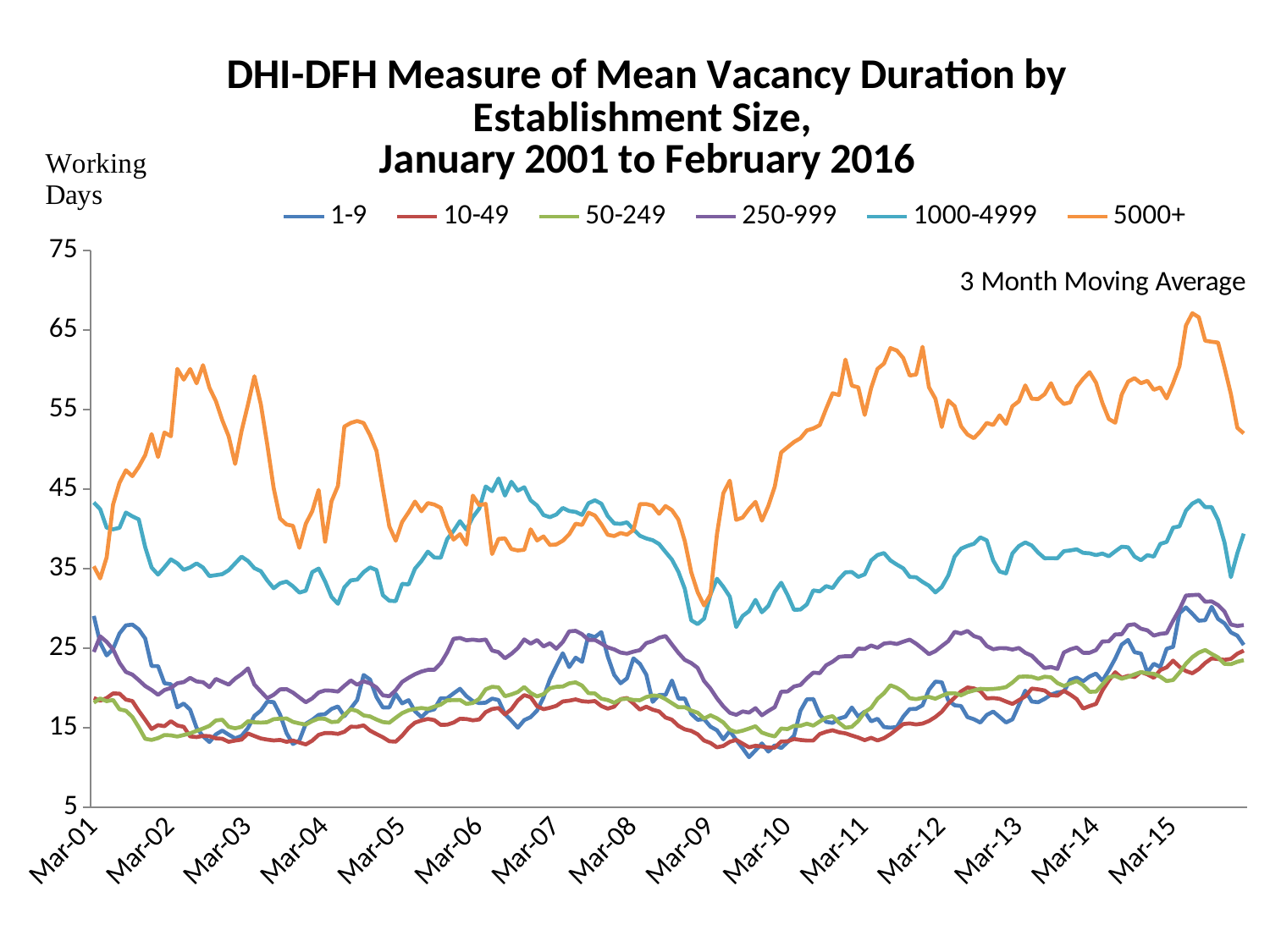
How many labelled tick marks are shown on the x axis? 15 Which establishment size series has the highest values across the chart? 5000+ Is the value for the 1-9 series at Mar-10 greater or less than 15? less What is the title of the chart? DHI-DFH Measure of Mean Vacancy Duration by Establishment Size, January 2001 to February 2016 What note appears in the upper right of the plot area? 3 Month Moving Average How many series does the legend list? 6 Does the 5000+ series rise or fall between Mar-09 and Mar-11? rise What kind of chart is shown on the slide? line chart At Mar-12, which series has the larger value, 5000+ or 1000-4999? 5000+ Is the value for the 5000+ series at Mar-15 greater or less than 45? greater Is the value for the 1000-4999 series at Mar-01 greater or less than 35? greater Which establishment size series has the second highest values across the chart? 1000-4999